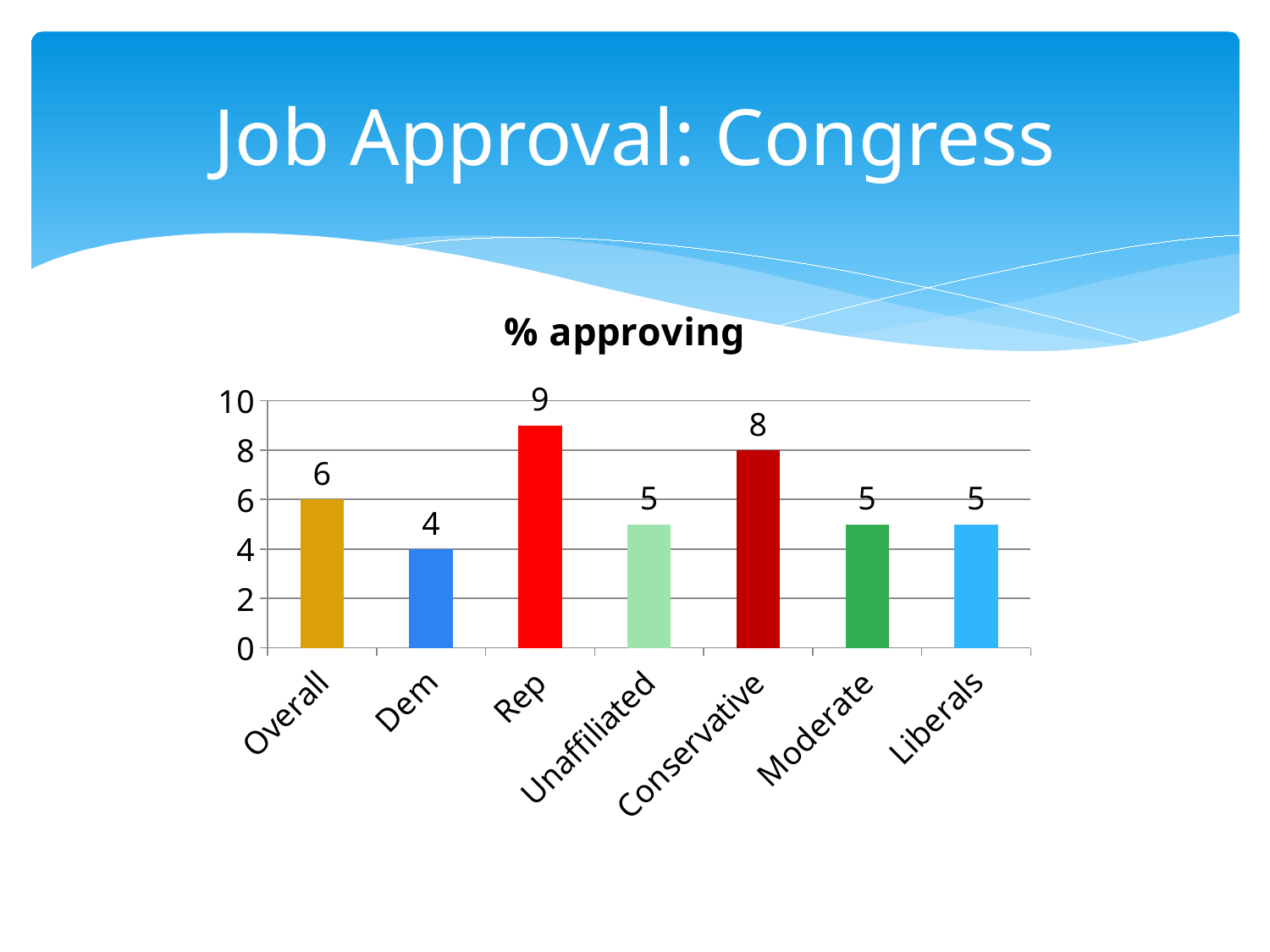
What is the value for Rep? 9 What is the value for Dem? 4 Which is larger, the value for Conservative or the value for Moderate? Conservative How many categories are shown on the x axis? 7 What is the value for Overall? 6 What is the title of the chart? % approving What kind of chart is this? Bar chart What is the difference between the values for Rep and Dem? 5 Which category has the highest value? Rep How many categories have a value of 5? 3 Which category has the lowest value? Dem What is the value for Conservative? 8